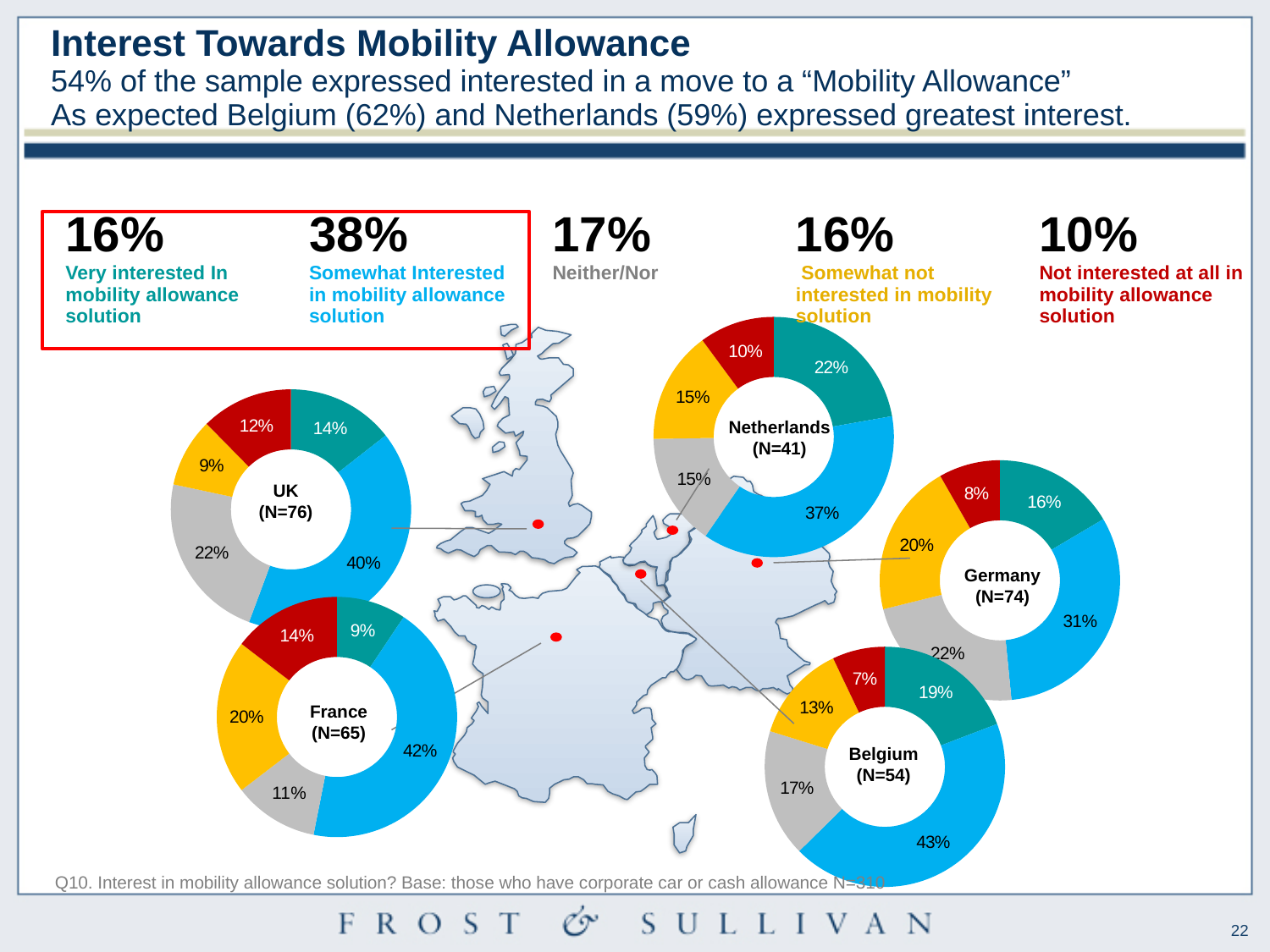
In the Belgium (N=54) chart, what share is shown for the red (not interested at all) slice? 7% In the UK (N=76) chart, what share is shown for the blue (somewhat interested) slice? 40% In the Belgium (N=54) chart, what is the difference between the blue (43%) slice and the grey (17%) slice? 26 percentage points In the Germany (N=74) chart, which slice is the largest? 31% (blue, somewhat interested) In the UK (N=76) chart, what is the combined share of the teal (14%) and blue (40%) slices? 54% What kind of chart is used to show the results for each country on the slide? Pie (donut) chart How many country pie charts are shown on the slide? 5 Which is larger: the blue (somewhat interested) slice in the France chart or the blue slice in the Germany chart? France (42%) What sample size is shown for the Netherlands chart? N=41 In the France (N=65) chart, which slice is the smallest? 9% (teal, very interested) According to the summary figures at the top of the slide, what percentage is 'Somewhat Interested in mobility allowance solution'? 38% In the Netherlands (N=41) chart, what share is shown for the teal (very interested) slice? 22%